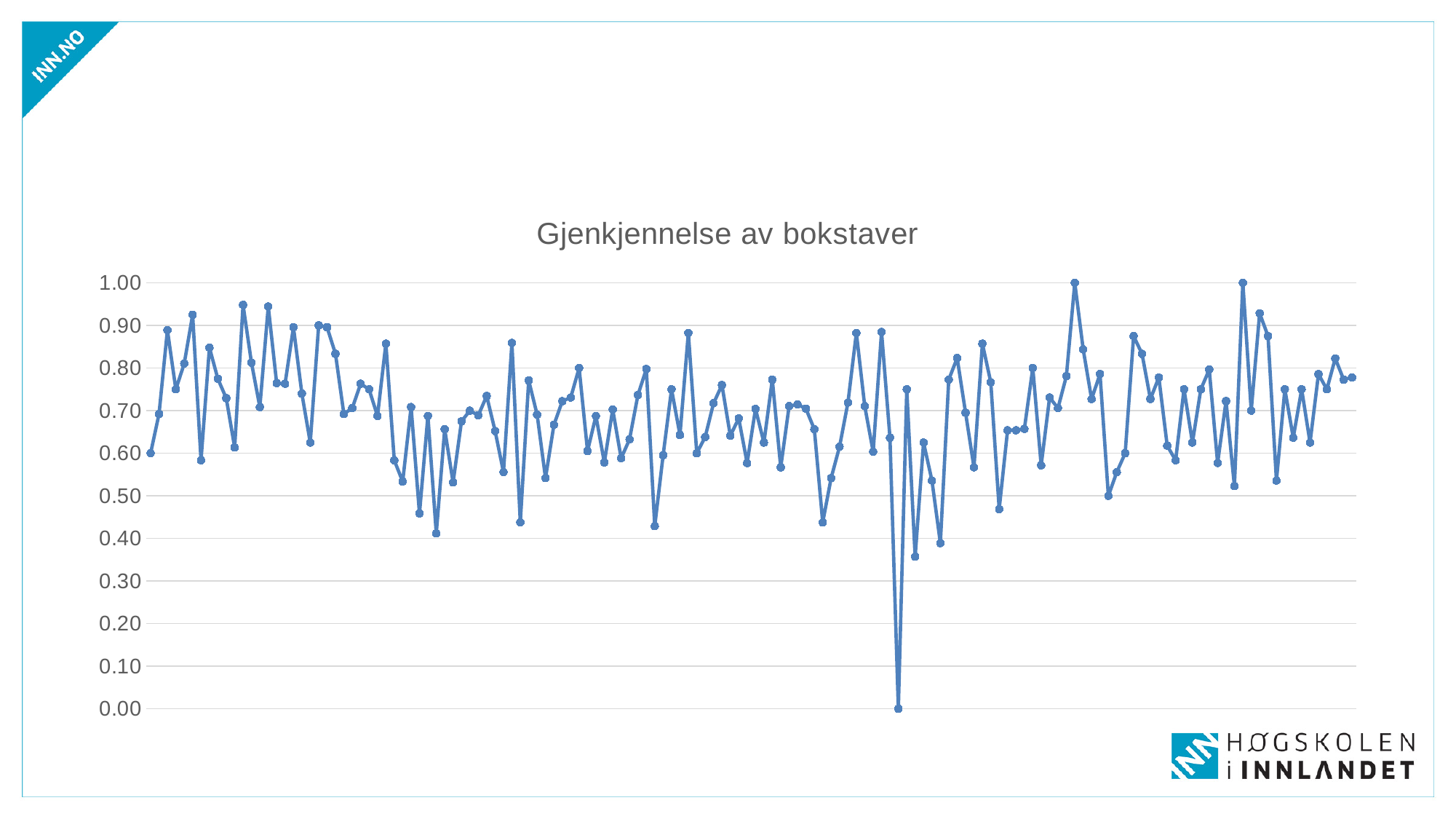
Does the chart display a legend? No Is the value of the first point on the line greater or less than 0.50? greater What kind of chart is shown on the slide? line chart What is the highest value reached by any point on the line? 1.00 Is the value of the lowest point on the line greater or less than 0.10? less What is the title of the chart? Gjenkjennelse av bokstaver Is the value of the last point on the line greater or less than 0.70? greater What is the lowest value reached by any point on the line? 0.00